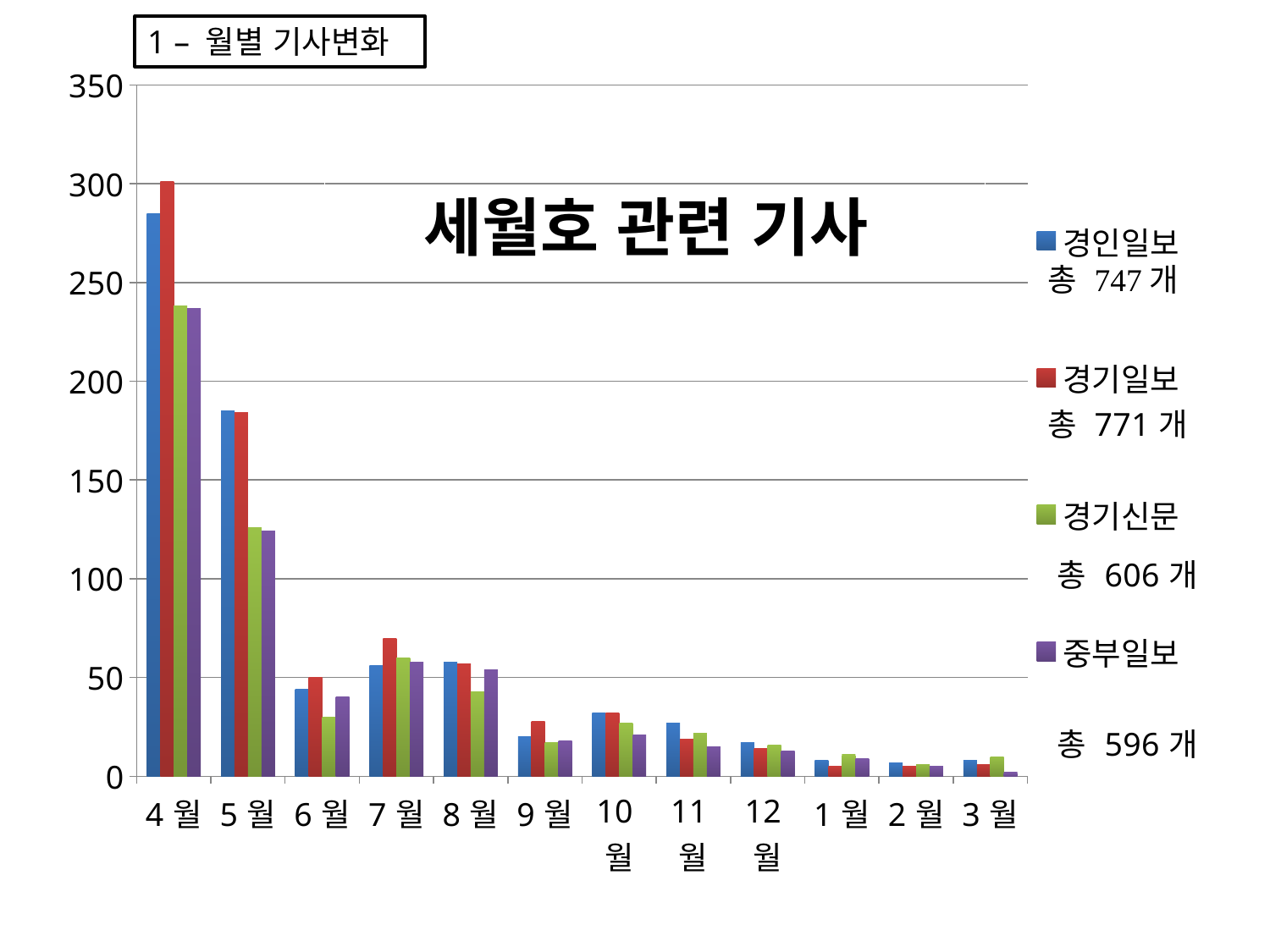
What is the title of the chart? 세월호 관련 기사 Is the value for 중부일보 in 5 월 greater or less than 150? less Is the value for 경인일보 in 4 월 greater or less than 250? greater Overall, do the values for 경기일보 rise or fall from 4 월 to 3 월? fall In which month is the value for 경인일보 highest? 4 월 In which month is the value for 중부일보 lowest? 3 월 How many series does the chart's legend list? 4 According to the legend, what is the total number of articles for 경기일보? 총 771 개 How many months are shown on the x axis of the chart? 12 In 4 월, which is larger: the value for 경인일보 or the value for 경기신문? 경인일보 What kind of chart is shown on the slide? bar chart Is the value for 경기일보 in 7 월 greater or less than 50? greater